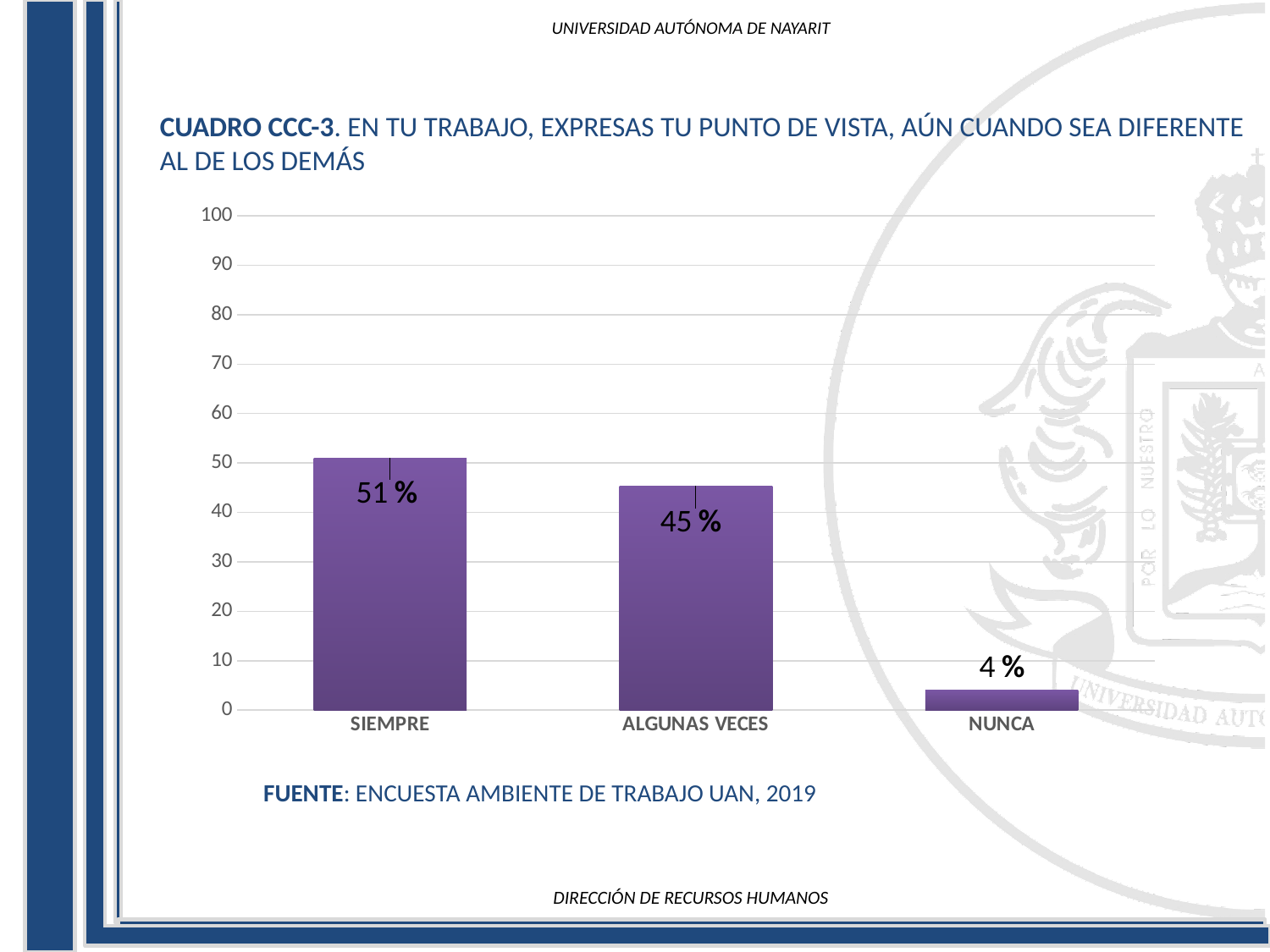
Is the value for NUNCA greater or less than 10? less What is the difference between the values for ALGUNAS VECES and NUNCA? 41 % What is the value for ALGUNAS VECES? 45 % What source is cited below the chart? ENCUESTA AMBIENTE DE TRABAJO UAN, 2019 How many categories are shown on the x axis? 3 What is the value for NUNCA? 4 % Which is larger, the value for SIEMPRE or the value for ALGUNAS VECES? SIEMPRE Which category has the highest value? SIEMPRE What is the value for SIEMPRE? 51 % Which category has the lowest value? NUNCA What kind of chart is shown on the slide? bar chart What is the difference between the values for SIEMPRE and ALGUNAS VECES? 6 %